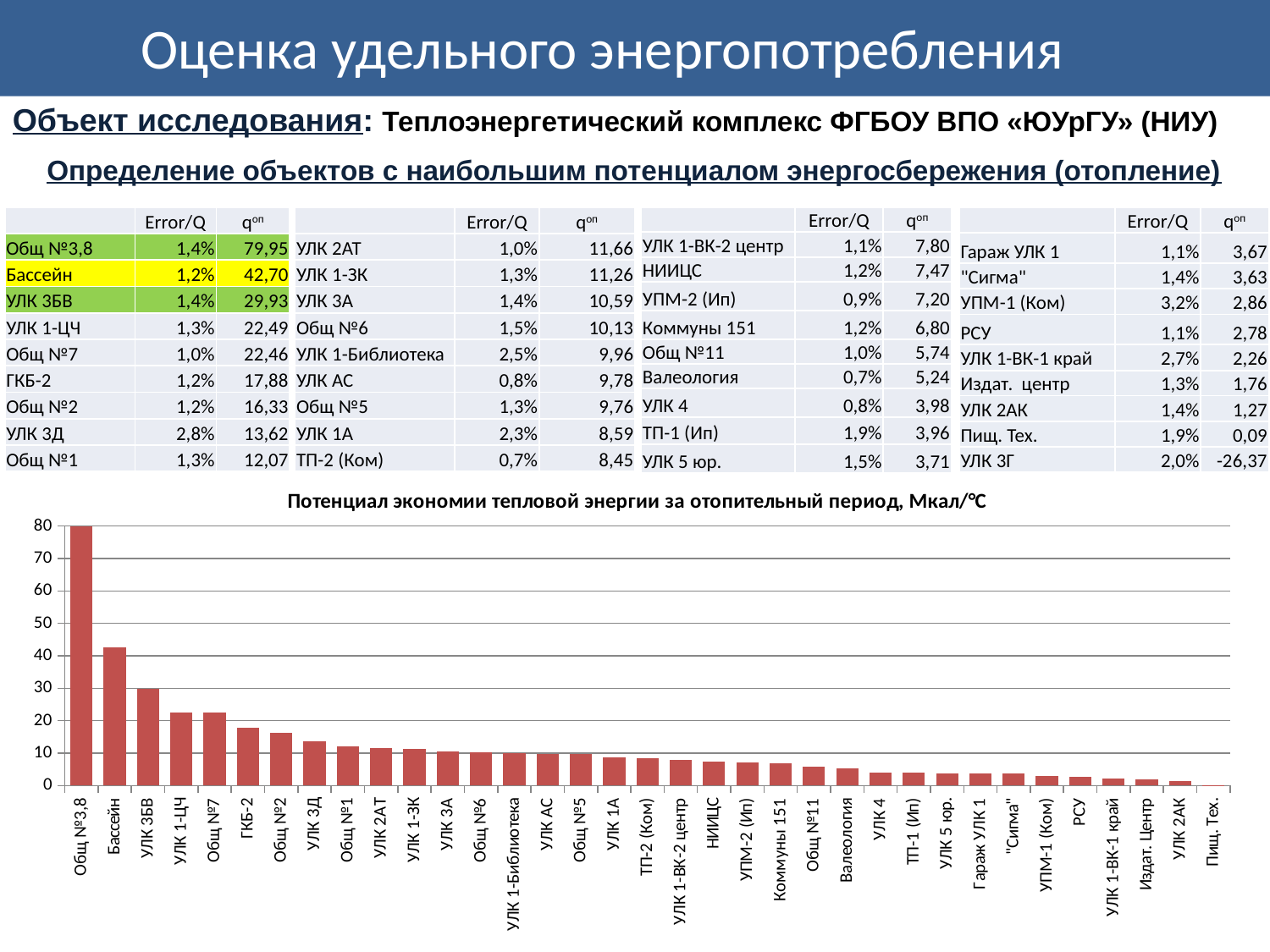
Is the value for УЛК 4 in the chart greater or less than 10? less Which category has the highest bar in the chart? Общ №3,8 Which category has the lowest bar in the chart? Пищ. Тех. Is the value for Общ №3,8 in the chart greater or less than 70? greater What kind of chart is shown on the slide? bar chart Do the bar values rise or fall from left to right along the x axis? fall Is the value for ГКБ-2 in the chart greater or less than 20? less What is the title of the chart? Потенциал экономии тепловой энергии за отопительный период, Мкал/°С How many bars (categories) are plotted in the chart? 35 Which is larger in the chart, the bar for Бассейн or the bar for УЛК 3БВ? Бассейн